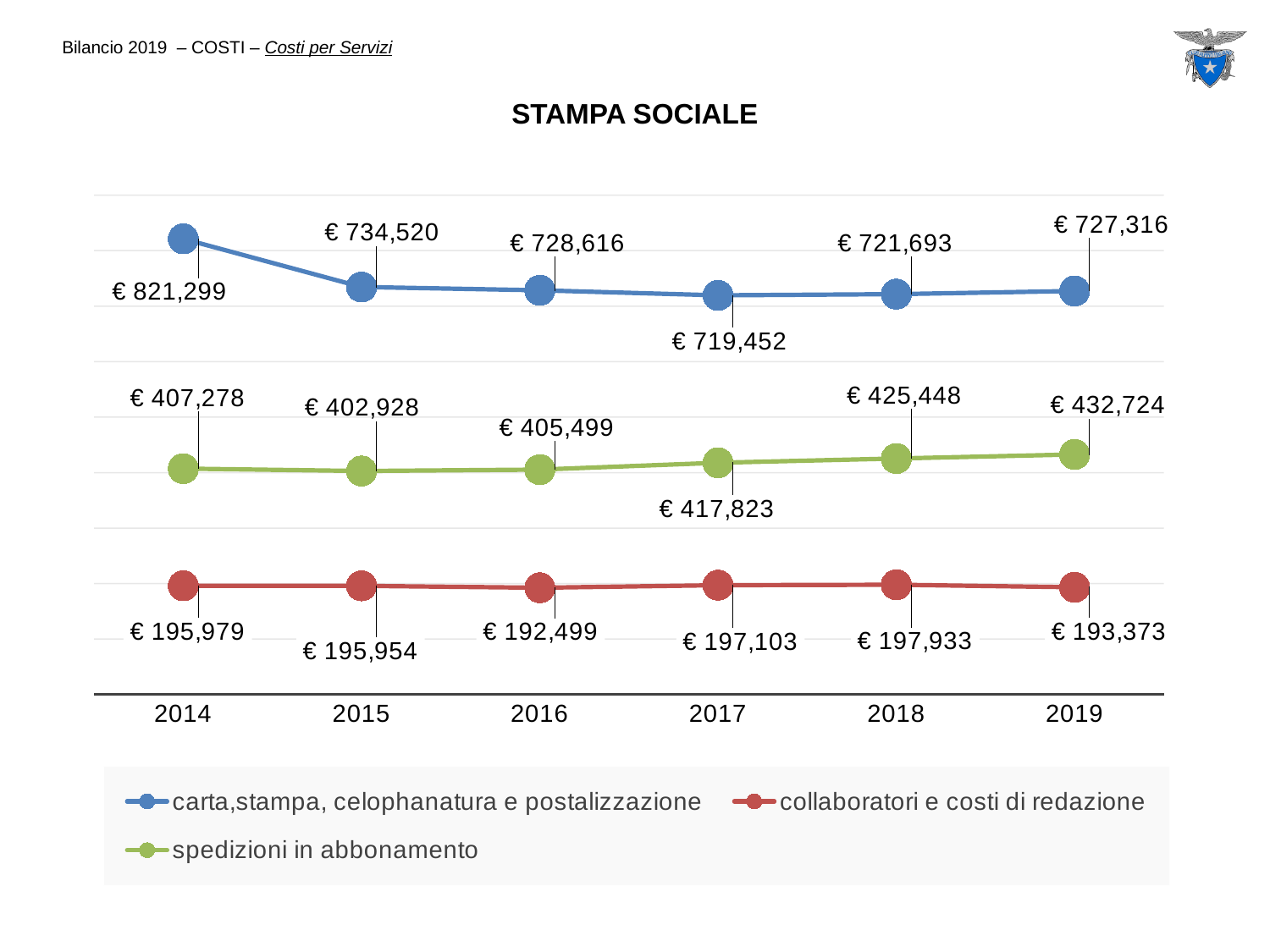
Which is larger: 'spedizioni in abbonamento' in 2018 or in 2019? 2019 What is the value for 'spedizioni in abbonamento' in 2017? € 417,823 What is the value for 'collaboratori e costi di redazione' in 2019? € 193,373 In which year is 'collaboratori e costi di redazione' highest? 2018 Does 'spedizioni in abbonamento' rise or fall from 2016 to 2019? Rise How many series does the legend list? 3 What is the title of the chart? STAMPA SOCIALE What is the value for 'carta,stampa, celophanatura e postalizzazione' in 2014? € 821,299 What type of chart is shown on the slide? Line chart In which year is 'carta,stampa, celophanatura e postalizzazione' lowest? 2017 By how much did 'carta,stampa, celophanatura e postalizzazione' decrease from 2014 to 2015? € 86,779 How many years are shown on the x axis? 6